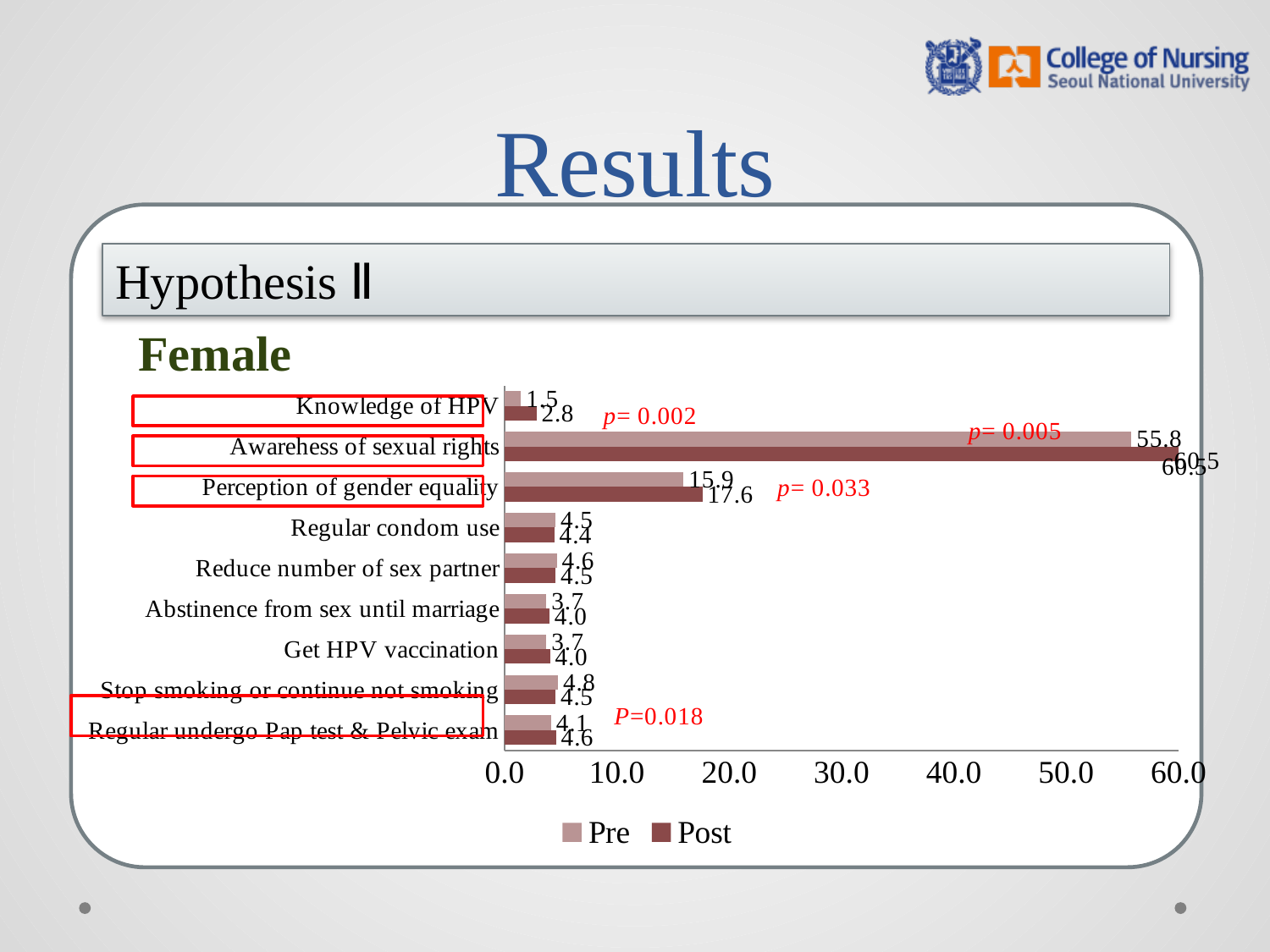
How many series does the legend list? 2 What is the difference between the Post and Pre values for Perception of gender equality? 1.7 Which is larger for Stop smoking or continue not smoking, the Pre value or the Post value? Pre How many categories are shown on the chart? 9 Which category has the lowest Pre value? Knowledge of HPV What is the Pre value for Awareness of sexual rights? 55.8 Is the Post value for Awareness of sexual rights greater or less than 50.0? greater What is the Post value for Regular undergo Pap test & Pelvic exam? 4.6 What is the Post value for Knowledge of HPV? 2.8 What kind of chart is shown on the slide? Bar chart Which category has the highest Pre value? Awareness of sexual rights What is the Pre value for Perception of gender equality? 15.9